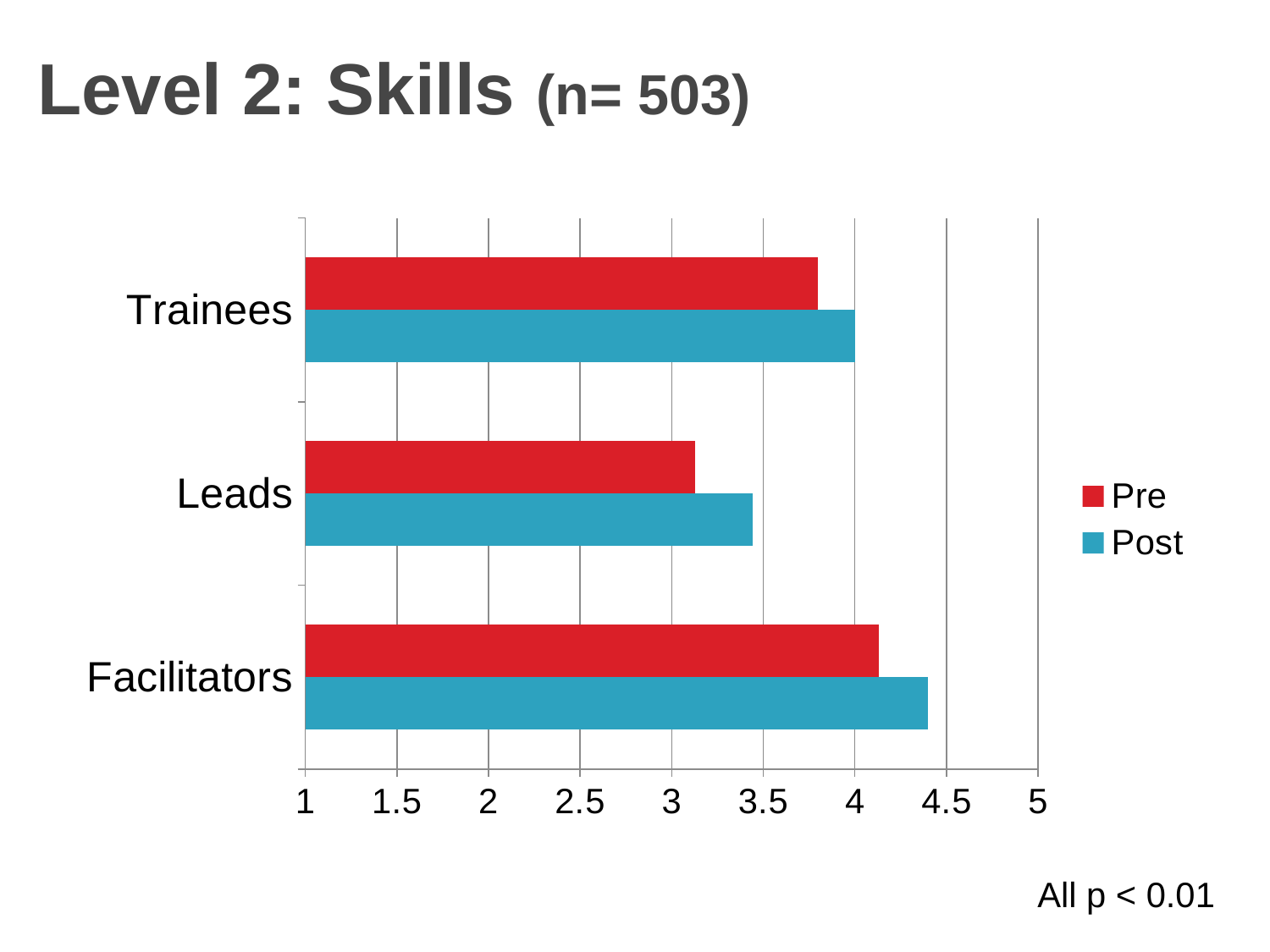
How many series does the legend list? 2 Is the Post value for Facilitators greater or less than 4? greater Which category has the highest Post value? Facilitators Which category has the highest Pre value? Facilitators What kind of chart is shown on the slide? bar chart Is the Pre value for Trainees greater or less than 4? less How many categories are shown on the chart? 3 Is the Pre value for Leads greater or less than 3.5? less What are the two series named in the legend? Pre and Post Which category has the lowest Pre value? Leads Which category has the lowest Post value? Leads For Trainees, which is larger, the Pre value or the Post value? Post